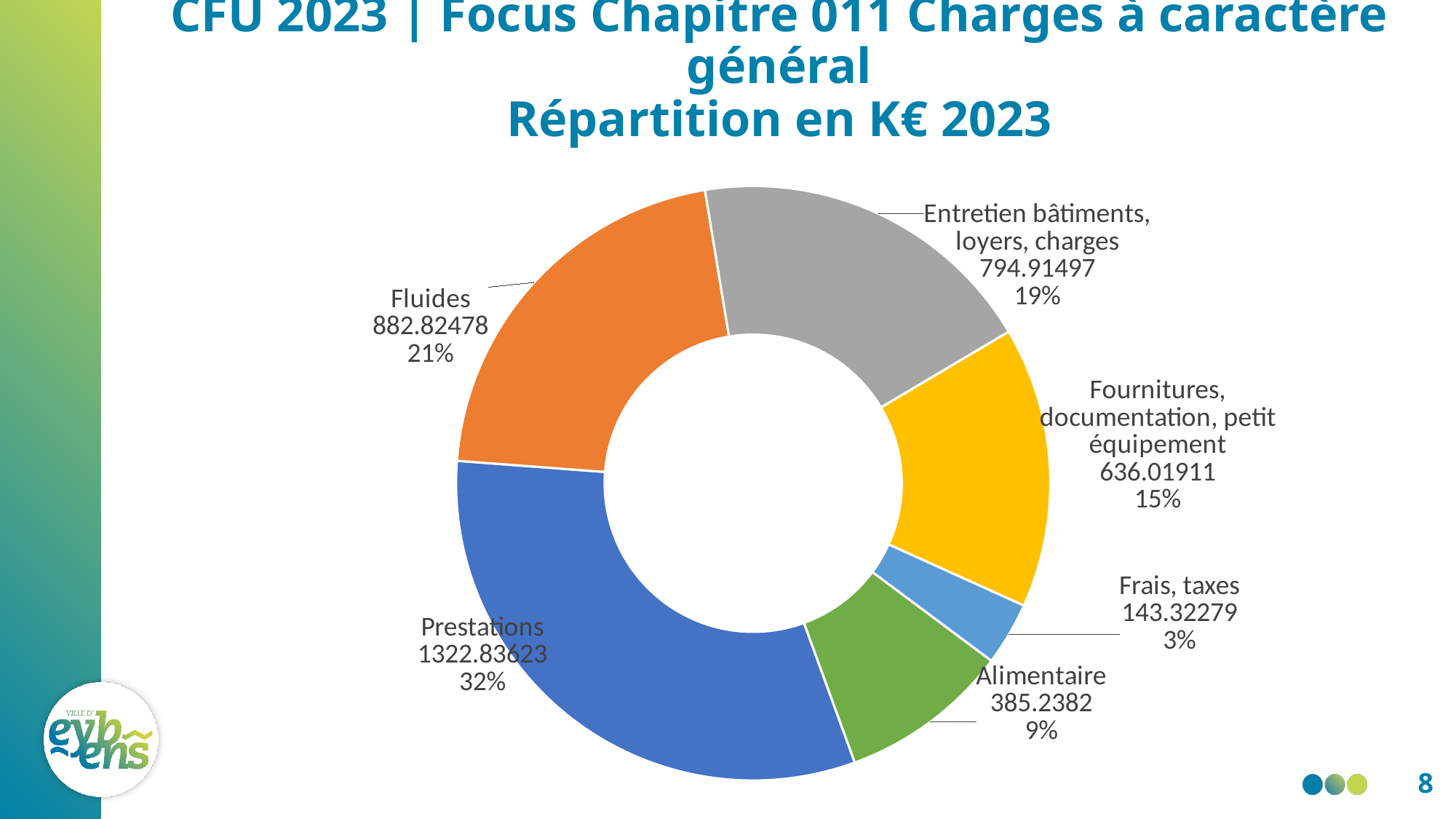
What is the value for Fluides? 882.82478 What share of the chart does Entretien bâtiments, loyers, charges represent? 19% What kind of chart is shown on the slide? Doughnut (pie) chart Which category has the smallest value? Frais, taxes What colour is the Prestations slice? Blue What is the value for Frais, taxes? 143.32279 What is the difference between the values for Fluides and Entretien bâtiments, loyers, charges? 87.90981 Which is larger, Fluides or Fournitures, documentation, petit équipement? Fluides What share of the chart does Alimentaire represent? 9% How many categories are shown in the chart? 6 What is the value for Prestations? 1322.83623 Which category has the largest value? Prestations